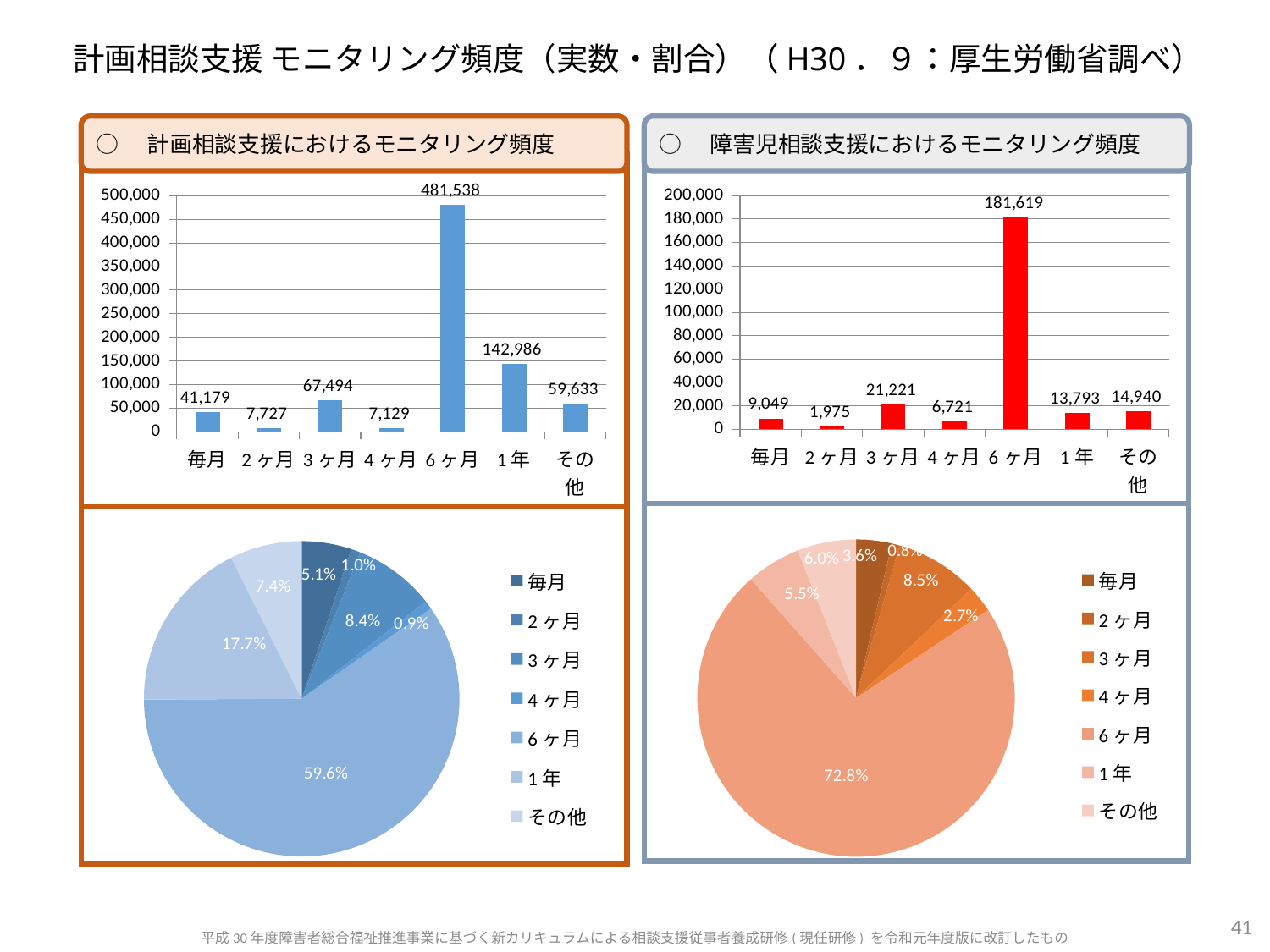
In the top-left bar chart (計画相談支援におけるモニタリング頻度), which category has the lowest value? 4ヶ月 In the top-left bar chart (計画相談支援におけるモニタリング頻度), what is the difference between the values for 毎月 and 2ヶ月? 33,452 In the top-right bar chart (障害児相談支援におけるモニタリング頻度), what is the value for 3ヶ月? 21,221 In the top-right bar chart (障害児相談支援におけるモニタリング頻度), which is larger, the value for 1年 or the value for その他? その他 In the top-left bar chart (計画相談支援におけるモニタリング頻度), what is the value for 1年? 142,986 In the bottom-left pie chart (計画相談支援), what share does 6ヶ月 have? 59.6% In the top-left bar chart (計画相談支援におけるモニタリング頻度), what is the value for 6ヶ月? 481,538 What kind of chart is the top-left chart (計画相談支援におけるモニタリング頻度)? Bar chart In the top-right bar chart (障害児相談支援におけるモニタリング頻度), how many categories are shown on the x axis? 7 In the top-right bar chart (障害児相談支援におけるモニタリング頻度), which category has the highest value? 6ヶ月 In the bottom-right pie chart (障害児相談支援), what share does 6ヶ月 have? 72.8% In the bottom-left pie chart (計画相談支援), what share does 1年 have? 17.7%